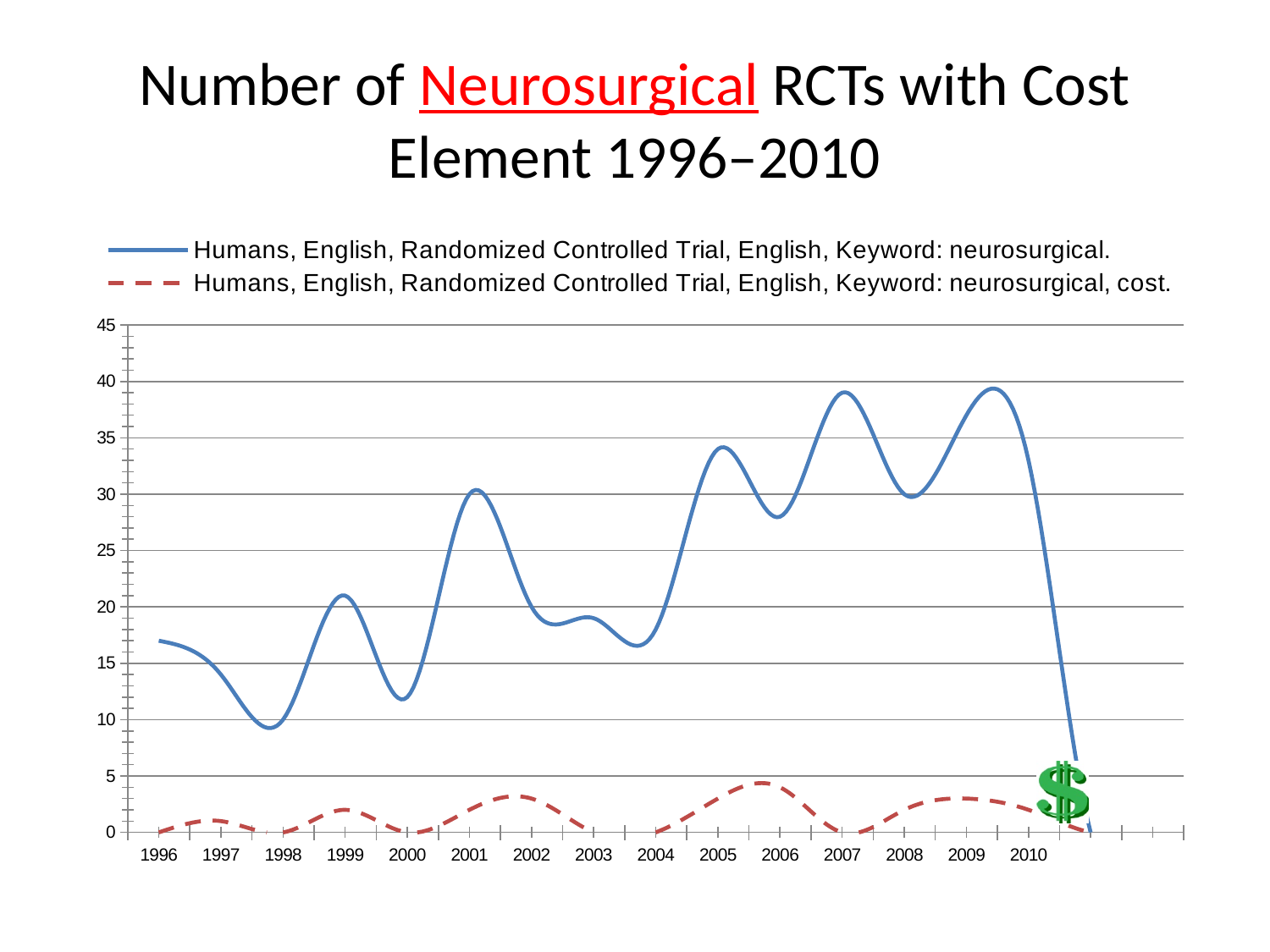
What kind of chart is shown on the slide? line chart Does the solid blue line (Keyword: neurosurgical) rise or fall from 2004 to 2005? rise Is the value of the dashed red line (Keyword: neurosurgical, cost) for 2006 greater or less than 5? less Which series is drawn as a dashed red line? Humans, English, Randomized Controlled Trial, English, Keyword: neurosurgical, cost. In which year does the solid blue line (Keyword: neurosurgical) reach its lowest value? 1998 How many series does the legend list? 2 How many years are labeled on the x axis? 15 For the solid blue line (Keyword: neurosurgical), which year has the larger value, 2004 or 2005? 2005 Is the value of the solid blue line (Keyword: neurosurgical) for 1998 greater or less than 15? less Is the value of the solid blue line (Keyword: neurosurgical) for 2001 greater or less than 25? greater For the solid blue line (Keyword: neurosurgical), which year has the larger value, 1999 or 2000? 1999